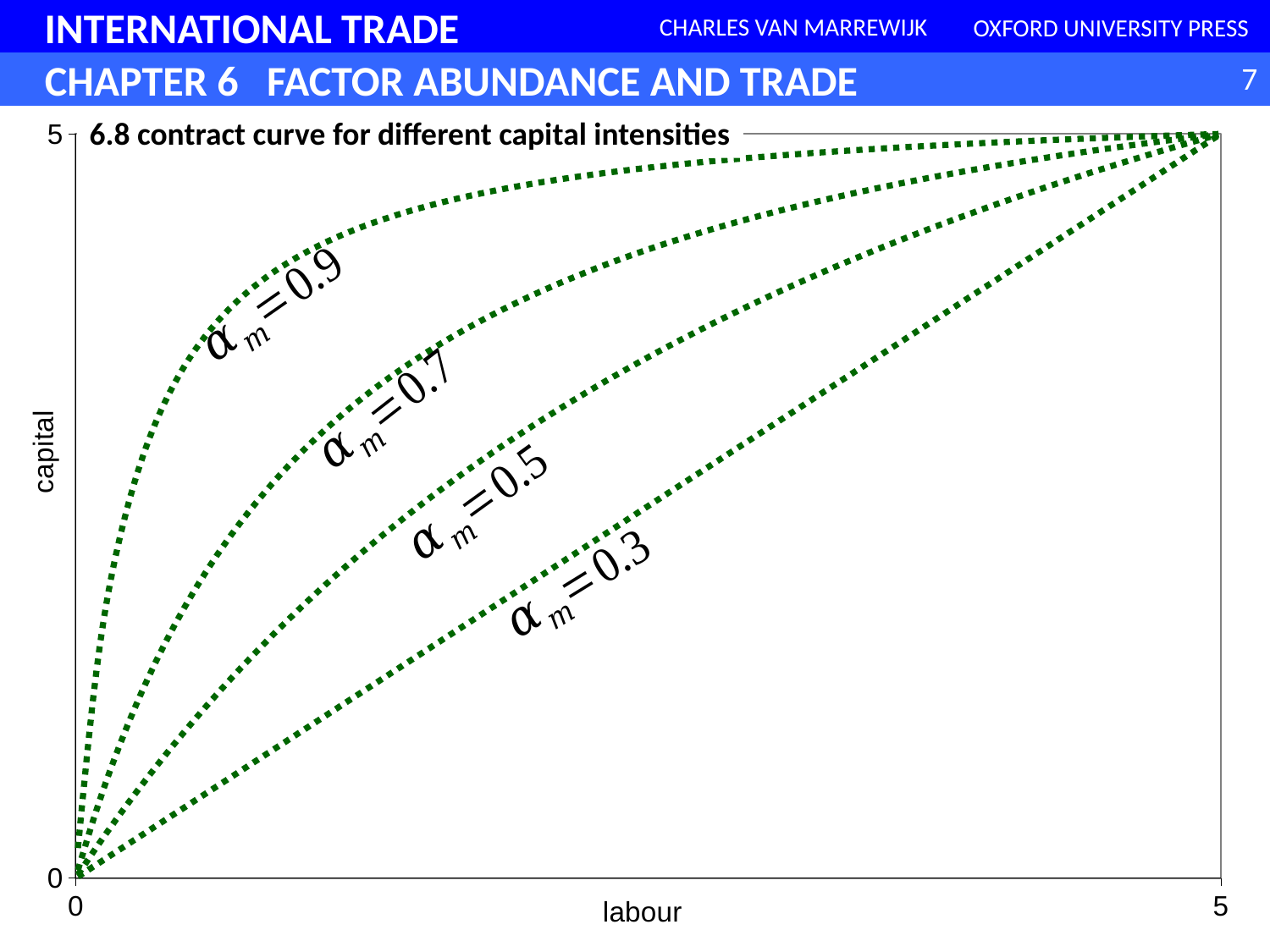
At a labour value of 1, which curve has the larger capital value, α_m = 0.7 or α_m = 0.5? α_m = 0.7 Do the curves rise or fall as labour increases from 0 to 5? rise What is the capital value of the α_m = 0.9 curve when labour is 5? 5 What is the maximum value shown on the capital axis? 5 Which curve lies lowest on the chart between the two endpoints? α_m = 0.3 What is the capital value of the α_m = 0.3 curve when labour is 0? 0 Which α_m value is labelled on the curve closest to the straight diagonal from (0,0) to (5,5)? 0.3 How many contract curves are plotted on the chart? 4 What is the title of the chart? 6.8 contract curve for different capital intensities What is the label of the horizontal axis? labour What kind of chart is shown on the slide? line chart Which curve lies highest on the chart between the two endpoints? α_m = 0.9